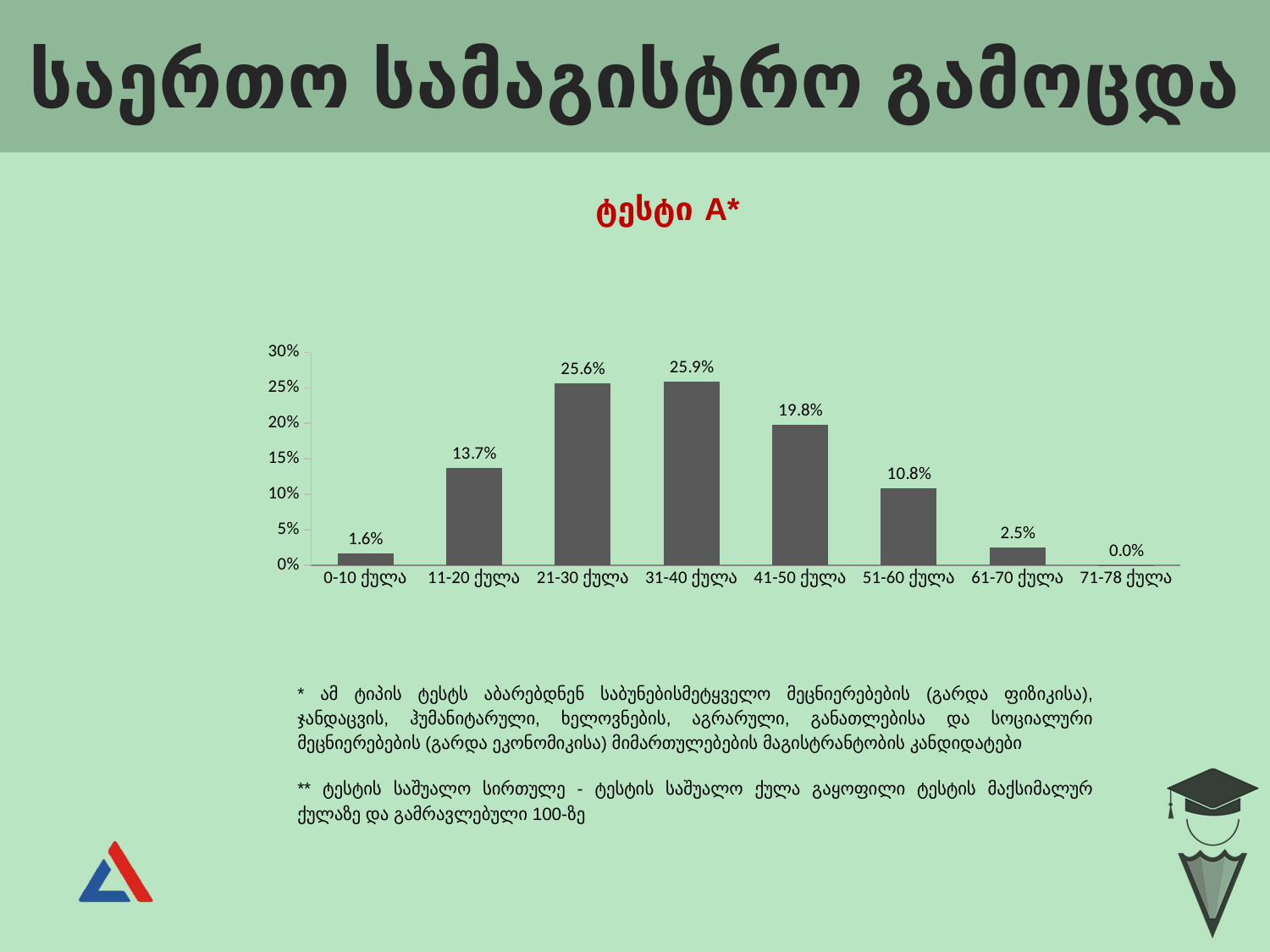
Do the values rise or fall from 31-40 ქულა to 71-78 ქულა? fall Which is larger, the value for 11-20 ქულა or the value for 61-70 ქულა? 11-20 ქულა What is the value for the 51-60 ქულა category? 10.8% What is the title of the chart? ტესტი A* How many categories are shown on the x axis? 8 Which category has the highest value? 31-40 ქულა Which category has the lowest value? 71-78 ქულა Is the value for 41-50 ქულა greater or less than 15%? greater What is the difference between the values for 41-50 ქულა and 51-60 ქულა? 9.0% What kind of chart is shown on the slide? bar chart What is the value for the 21-30 ქულა category? 25.6% What is the value for the 0-10 ქულა category? 1.6%